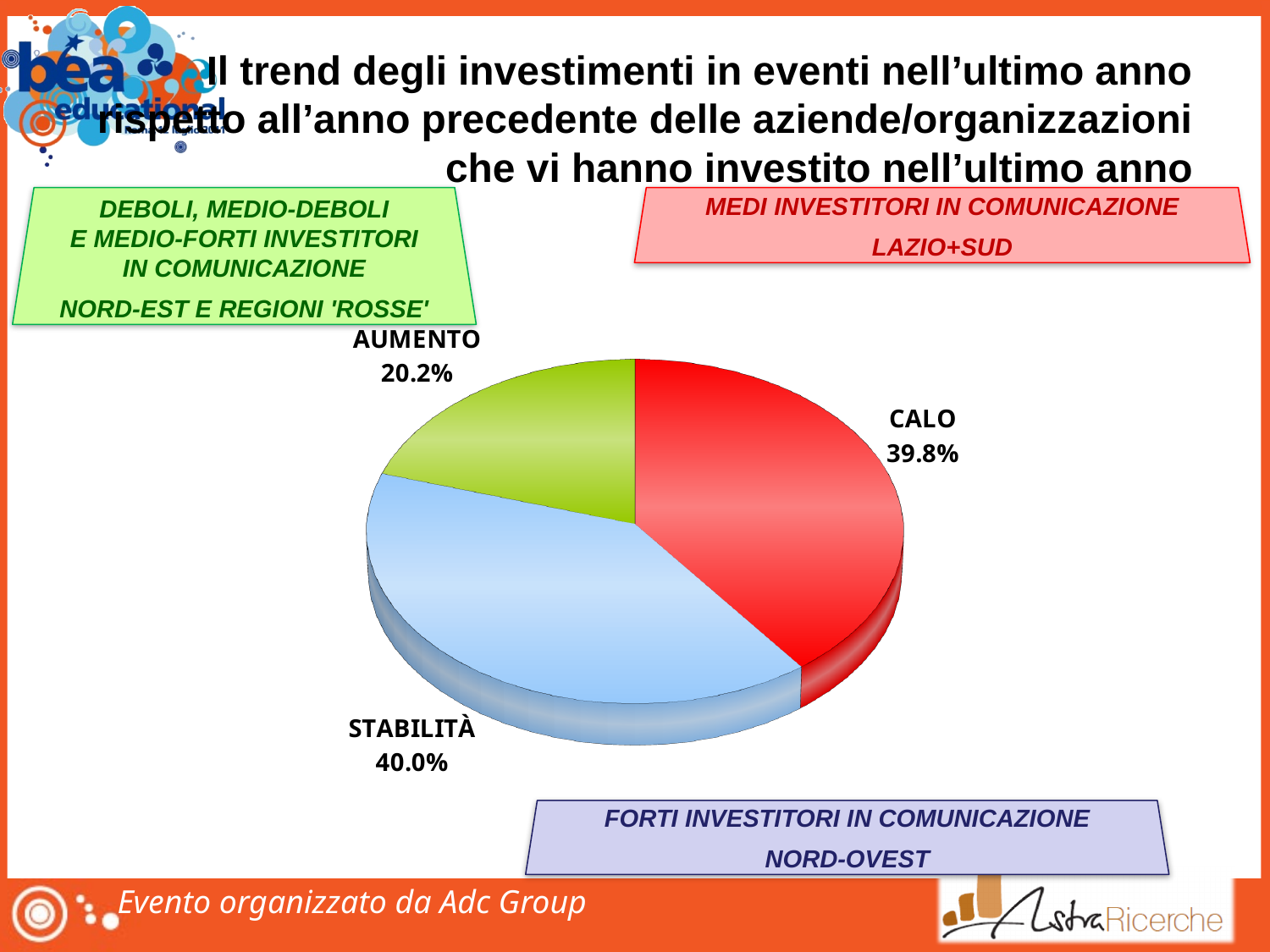
What percentage does the CALO slice of the pie chart represent? 39.8% How many slices does the pie chart have? 3 What is the difference in percentage points between the CALO and AUMENTO slices? 19.6 What is the difference in percentage points between the STABILITÀ and CALO slices? 0.2 What percentage does the STABILITÀ slice of the pie chart represent? 40.0% What colour is the CALO slice of the pie chart? Red What colour is the STABILITÀ slice of the pie chart? Light blue What kind of chart is shown on the slide? Pie chart Which slice of the pie chart is the smallest? AUMENTO What percentage does the AUMENTO slice of the pie chart represent? 20.2% Which slice of the pie chart is the largest? STABILITÀ Which is larger in the pie chart, CALO or AUMENTO? CALO